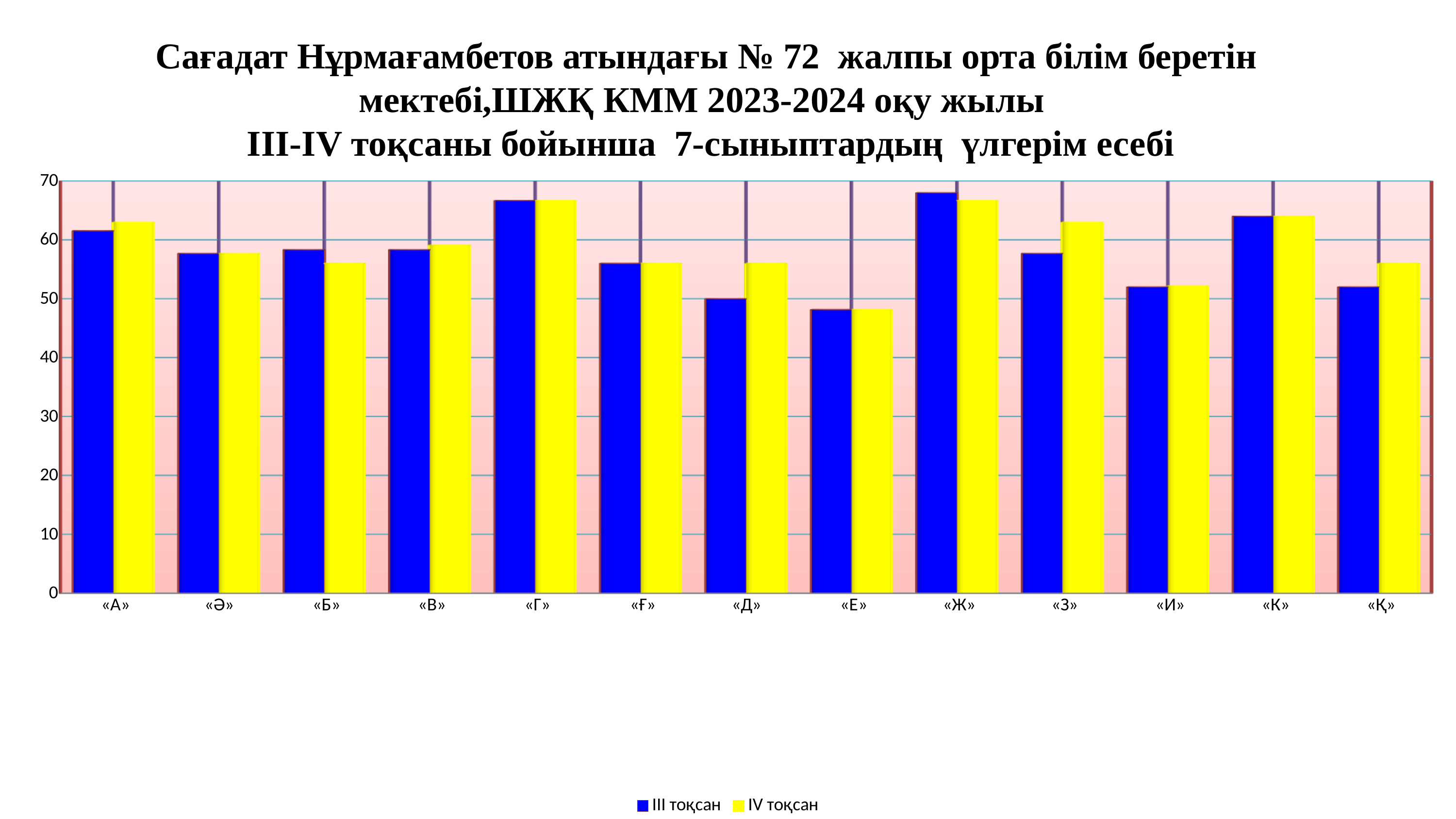
For «З», which series has the larger value, III тоқсан or IV тоқсан? IV тоқсан How many categories (classes) are shown on the x axis of the chart? 13 What kind of chart is shown on the slide? bar chart Is the III тоқсан value for «Г» greater or less than 60? greater Is the IV тоқсан value for «И» greater or less than 60? less What are the two series named in the legend? III тоқсан and IV тоқсан Is the IV тоқсан value for «А» greater or less than 60? greater For «Д», which series has the larger value, III тоқсан or IV тоқсан? IV тоқсан Which category has the lowest IV тоқсан value? «Е» Which colour represents the IV тоқсан series? yellow How many series does the chart's legend list? 2